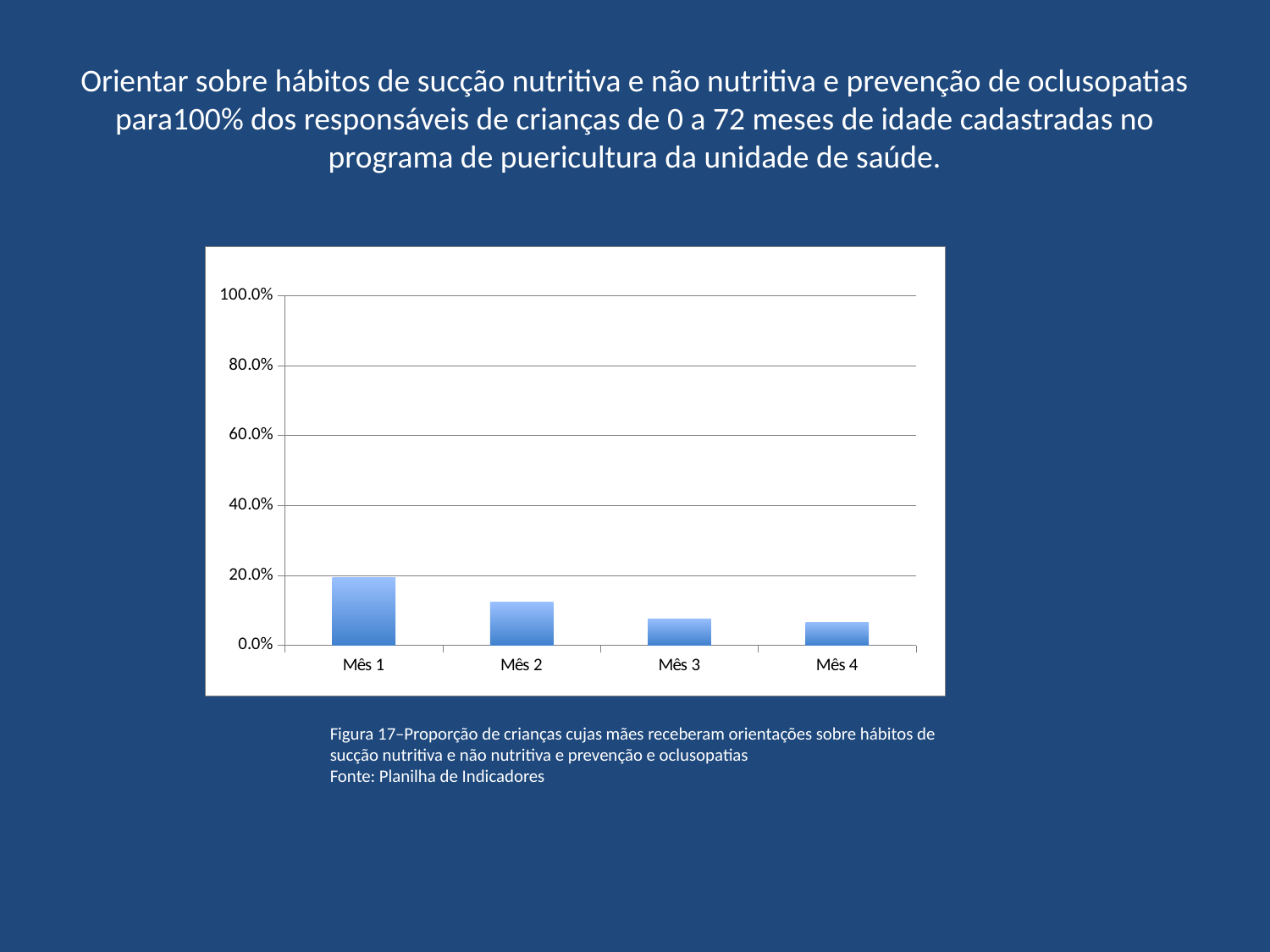
Is the value for Mês 3 greater or less than 20.0%? less Which is larger, the value for Mês 1 or the value for Mês 2? Mês 1 What is the label of the first category on the x axis? Mês 1 What kind of chart is shown on the slide? bar chart How many categories (months) are plotted on the x axis? 4 What is the highest value shown on the y axis? 100.0% Which is larger, the value for Mês 2 or the value for Mês 4? Mês 2 Do the values rise or fall from Mês 1 to Mês 4? fall Is the value for Mês 2 greater or less than 20.0%? less Which month has the highest bar? Mês 1 Is the value for Mês 1 greater or less than 40.0%? less